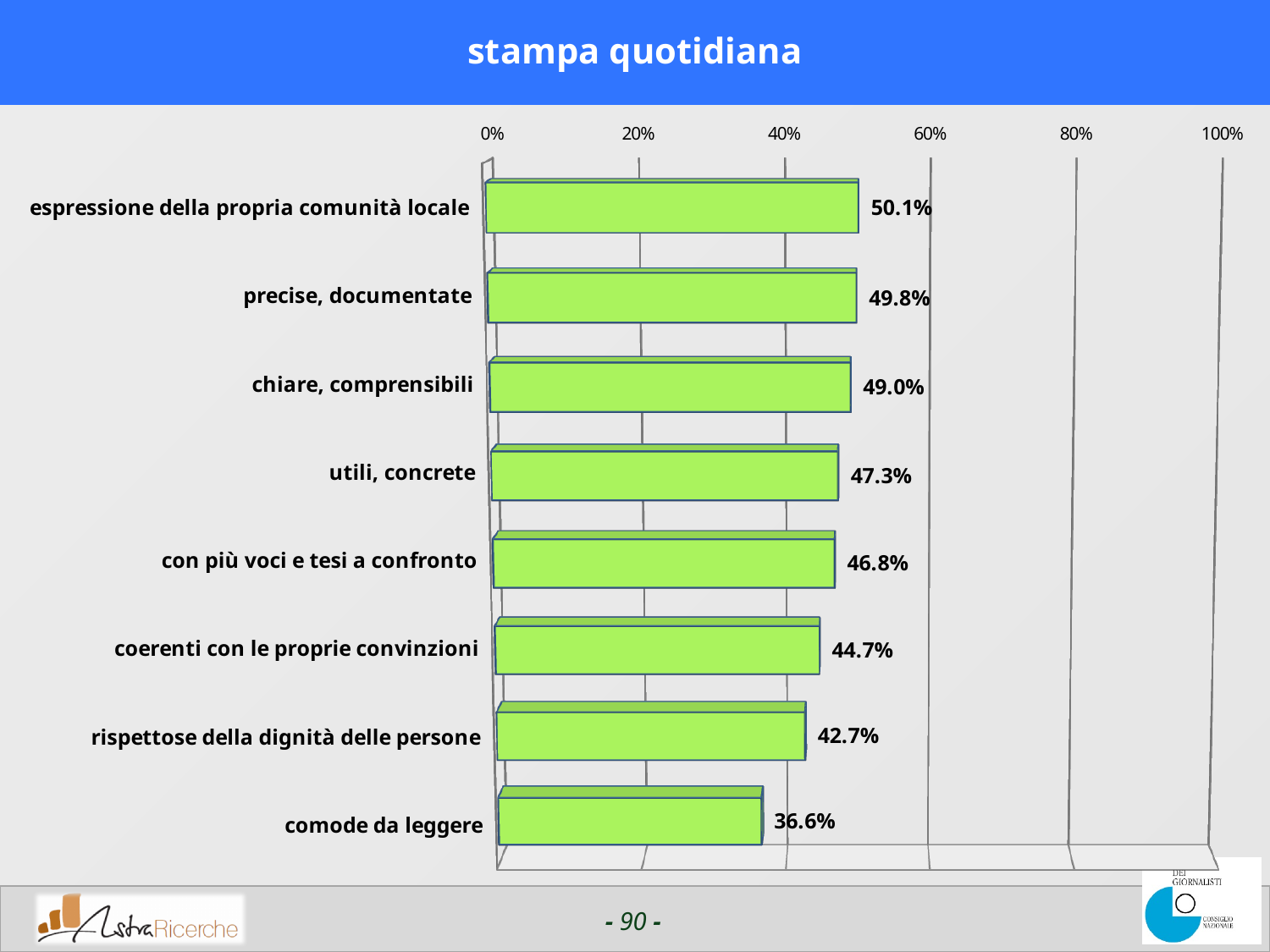
Which category has the highest value? espressione della propria comunità locale How many categories are shown in the chart? 8 What kind of chart is shown on the slide? bar chart Is the value for "comode da leggere" greater or less than 40%? less What is the value for "rispettose della dignità delle persone"? 42.7% What is the value for "espressione della propria comunità locale"? 50.1% What is the value for "comode da leggere"? 36.6% Which category has the lowest value? comode da leggere What is the difference between the values for "coerenti con le proprie convinzioni" and "rispettose della dignità delle persone"? 2.0% Which is larger: the value for "chiare, comprensibili" or the value for "con più voci e tesi a confronto"? chiare, comprensibili What is the value for "utili, concrete"? 47.3% What is the difference between the values for "espressione della propria comunità locale" and "comode da leggere"? 13.5%